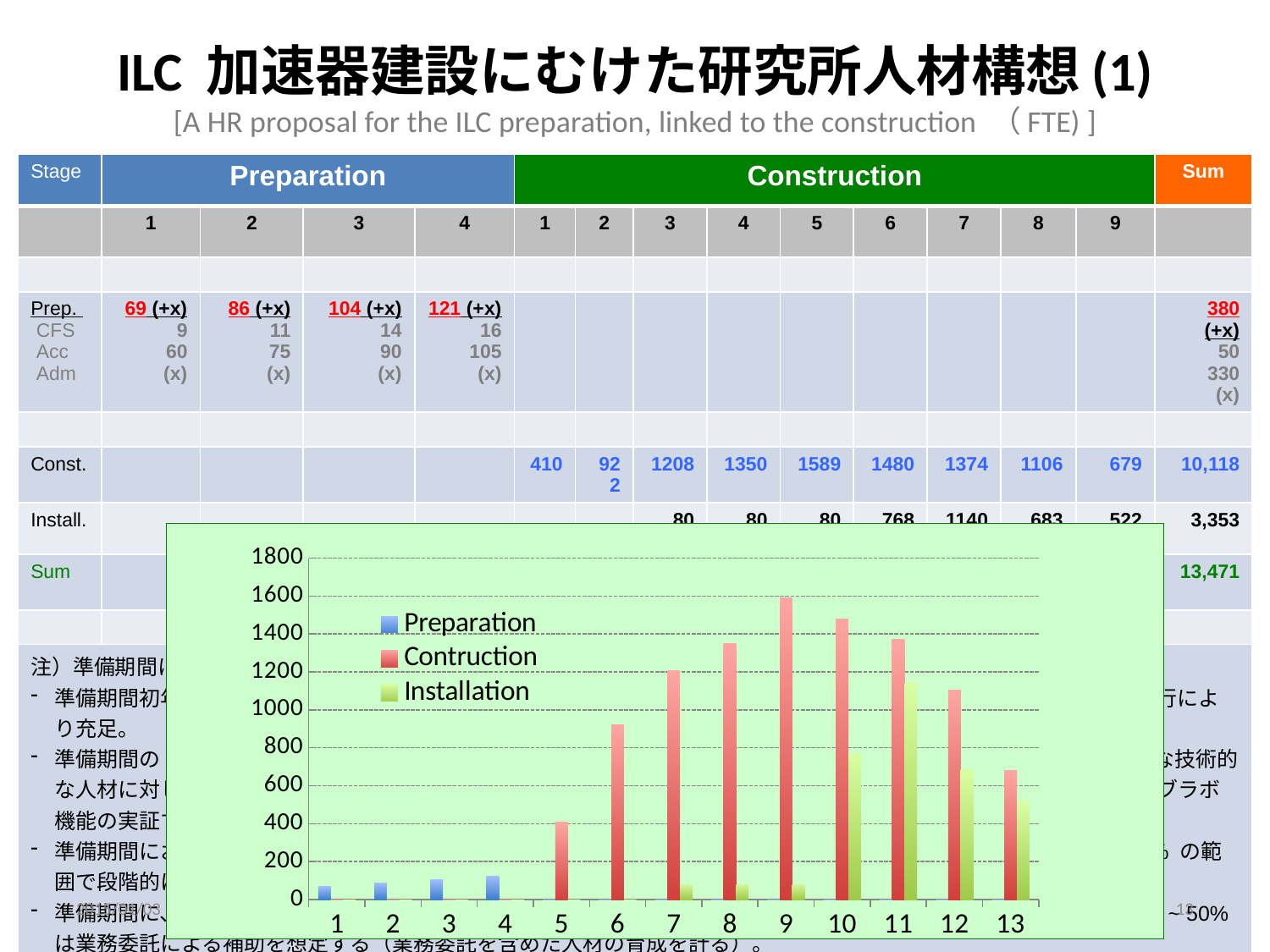
What are the three series named in the chart legend? Preparation, Contruction, Installation Do the Contruction bars rise or fall from category 5 to category 9? rise Is the Contruction value at category 5 greater or less than 600? less How many categories are shown along the x axis of the chart? 13 At which x-axis category is the Installation bar highest? 11 At which x-axis category is the Contruction bar highest? 9 What type of chart is shown on the slide? bar chart How many series does the chart legend list? 3 Is the Contruction value at category 9 greater or less than 1400? greater Is the Installation value at category 11 greater or less than 1000? greater At which x-axis category is the Contruction bar lowest? 5 Which is larger, the Contruction bar at category 8 or the Contruction bar at category 12? category 8